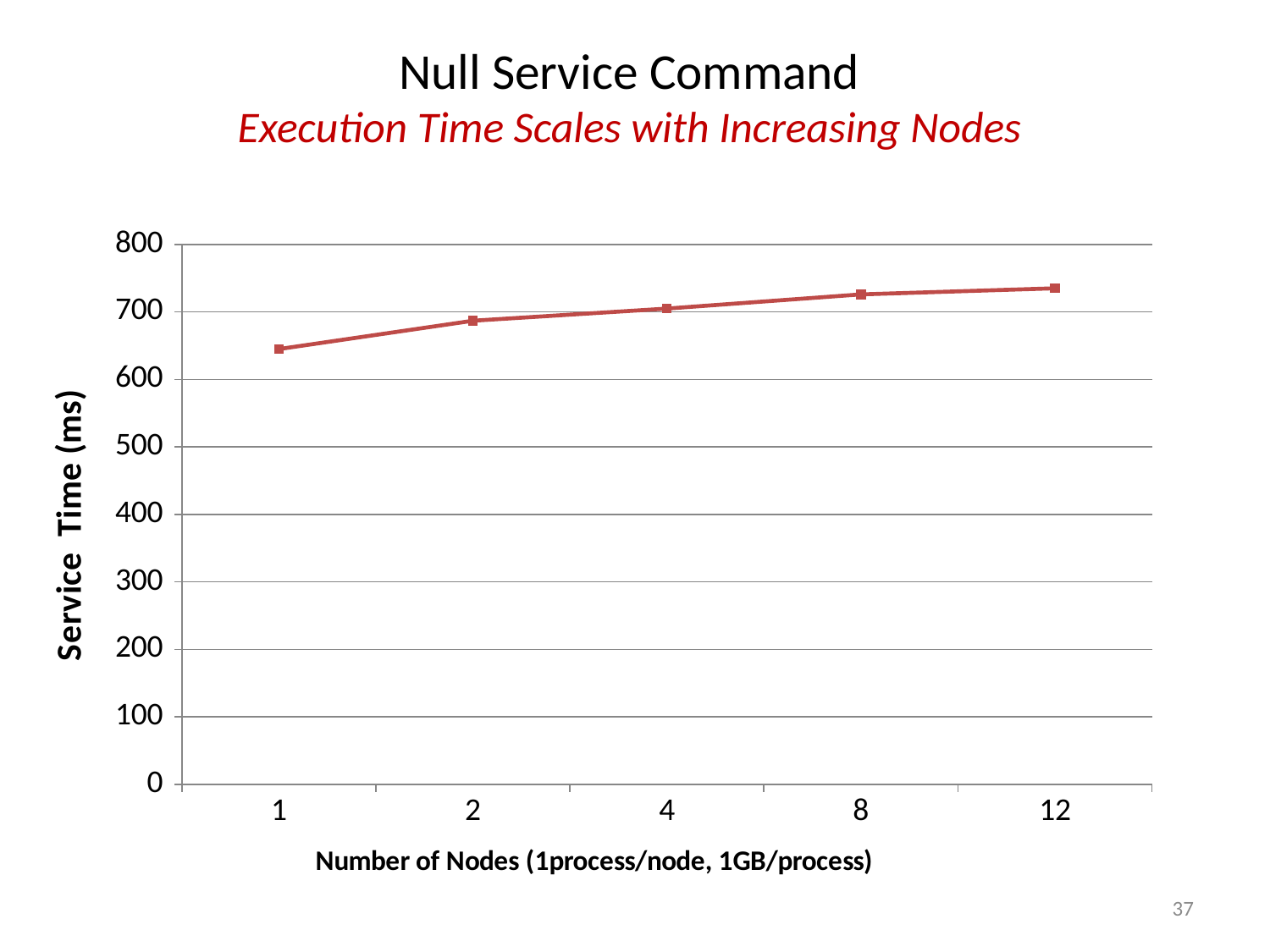
Is the service time for 1 node greater or less than 700? less What kind of chart is shown on the slide? line chart How many data points are plotted on the chart? 5 Does the service time rise or fall as the number of nodes increases along the x axis? rise Is the service time for 1 node greater or less than 600? greater Which has a larger service time, 2 nodes or 12 nodes? 12 nodes Is the service time for 8 nodes greater or less than 800? less What is the label of the y axis? Service Time (ms) Which number of nodes has the lowest service time? 1 What is the label of the x axis? Number of Nodes (1process/node, 1GB/process) Which has a larger service time, 1 node or 8 nodes? 8 nodes